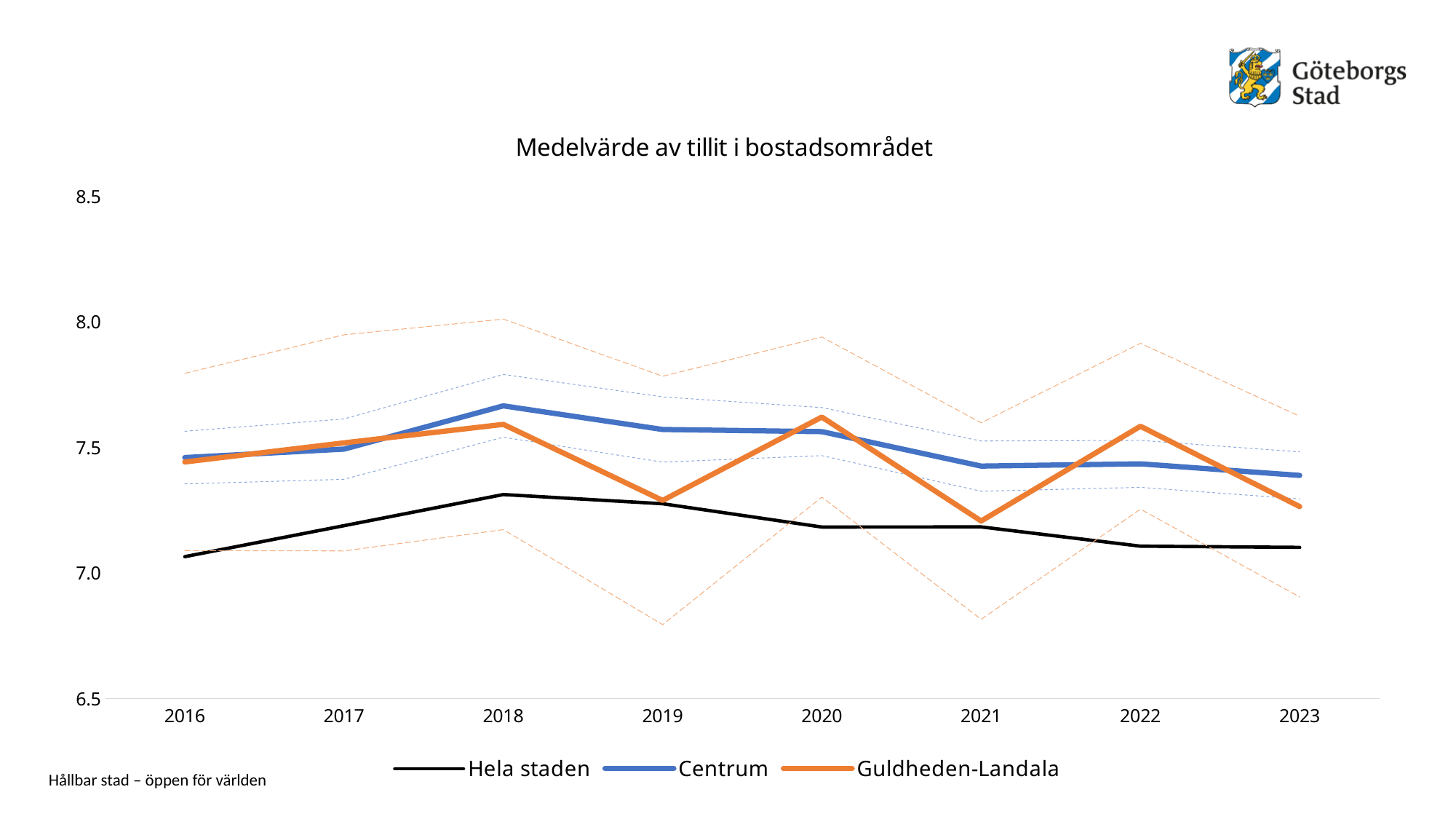
What kind of chart is shown on the slide? Line chart How many series does the legend list? 3 In which year does the Centrum line reach its highest value? 2018 What is the title of the chart? Medelvärde av tillit i bostadsområdet How many years are shown on the x axis? 8 Is the value for Hela staden in 2016 greater or less than 7.5? less Does the Hela staden line rise or fall from 2018 to 2023? Fall Is the value for Guldheden-Landala in 2021 greater or less than 7.5? less Is the value for Centrum in 2018 greater or less than 7.5? greater In which year does the Hela staden line reach its highest value? 2018 In 2019, which is larger: the value for Centrum or the value for Guldheden-Landala? Centrum Which colour is used for the Centrum line? Blue